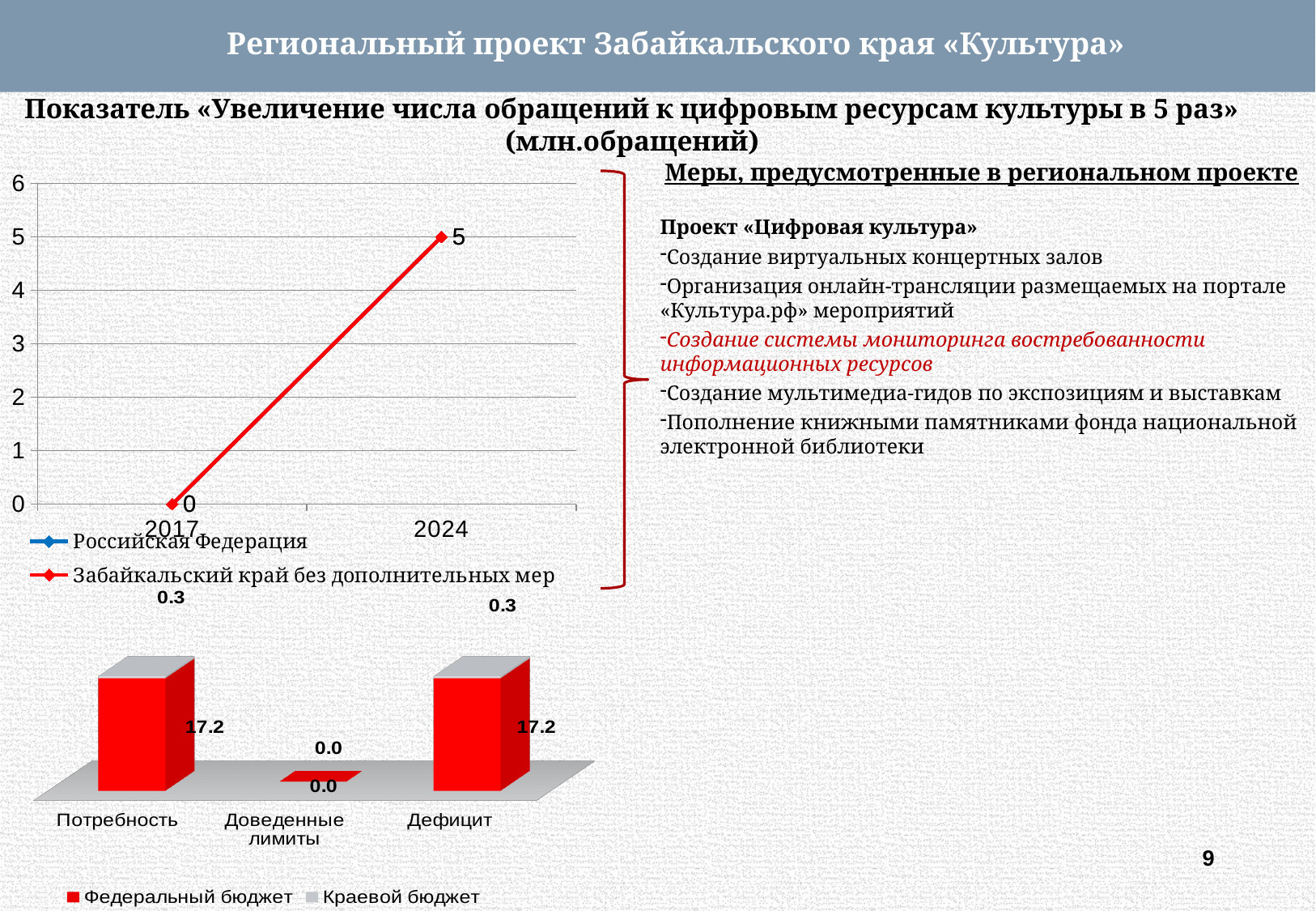
In the bottom bar chart, what is the value of 'Федеральный бюджет' for 'Потребность'? 17.2 In the top line chart, does the value rise or fall from 2017 to 2024? rise In the bottom bar chart, what is the difference between the 'Федеральный бюджет' values for 'Потребность' and 'Доведенные лимиты'? 17.2 What kind of chart is the top chart on the slide? line chart How many years are shown on the x axis of the top line chart? 2 In the top line chart, what is the value for 2017 for the series 'Забайкальский край без дополнительных мер'? 0 How many series does the legend of the top line chart list? 2 In the bottom bar chart, what is the value of 'Федеральный бюджет' for 'Доведенные лимиты'? 0.0 How many series does the legend of the bottom bar chart list? 2 In the bottom bar chart, which category has the lowest value for 'Федеральный бюджет'? Доведенные лимиты In the top line chart, what is the value for 2024 for the series 'Забайкальский край без дополнительных мер'? 5 In the bottom bar chart, what is the value of 'Федеральный бюджет' for 'Дефицит'? 17.2